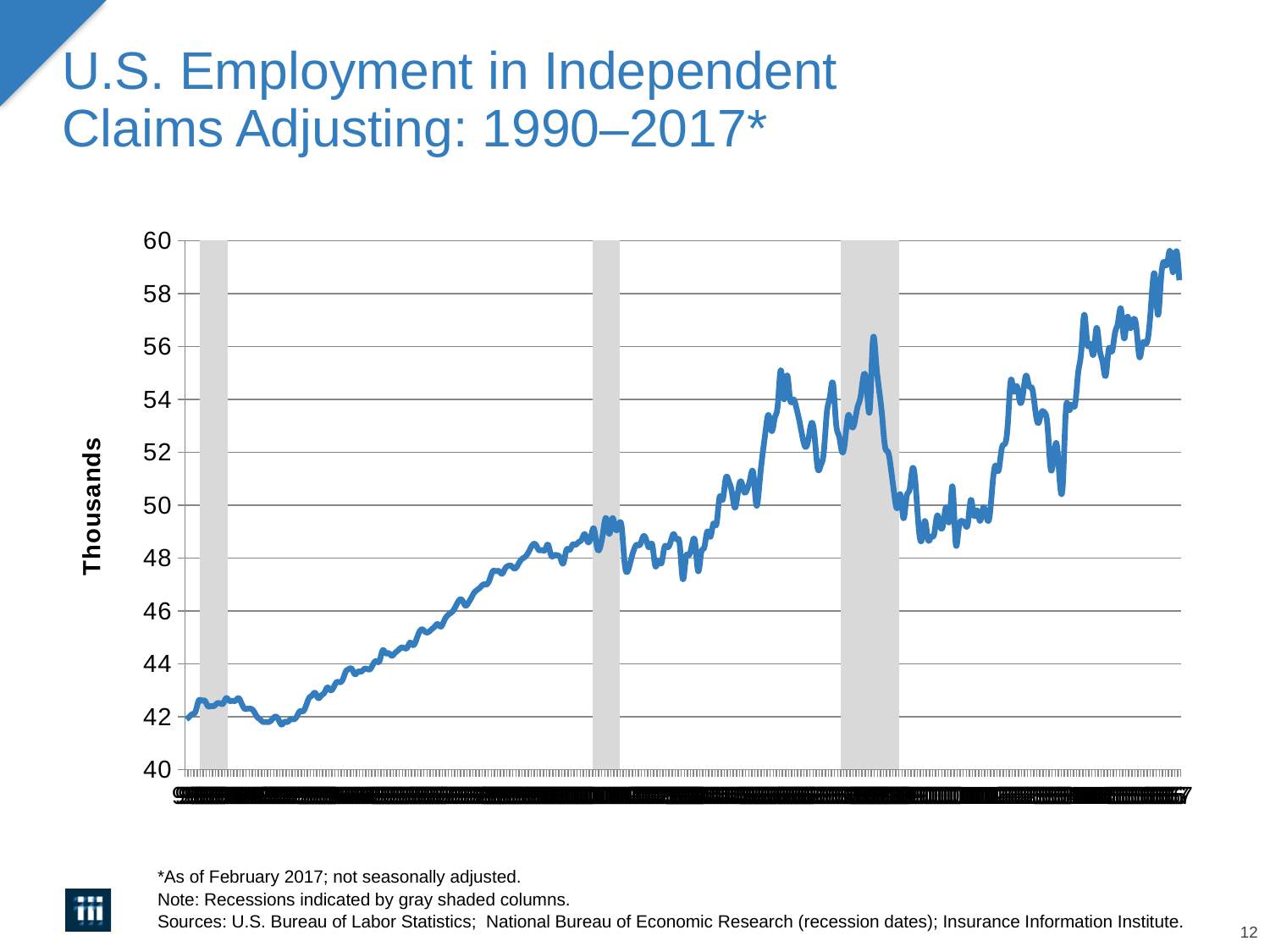
Is the value at the end of the series greater or less than 60? less Is the value at the start of the series (far left) greater or less than 44? less What kind of chart is shown on the slide? line chart What is the label on the vertical axis of the chart? Thousands How many gray shaded recession columns are shown on the chart? 3 Overall, do the values rise or fall from the left to the right of the chart? rise Is the highest point of the line greater or less than 58? greater Which is larger, the value at the start of the series or the value at the end of the series? the value at the end of the series What is the title of the chart on the slide? U.S. Employment in Independent Claims Adjusting: 1990–2017*